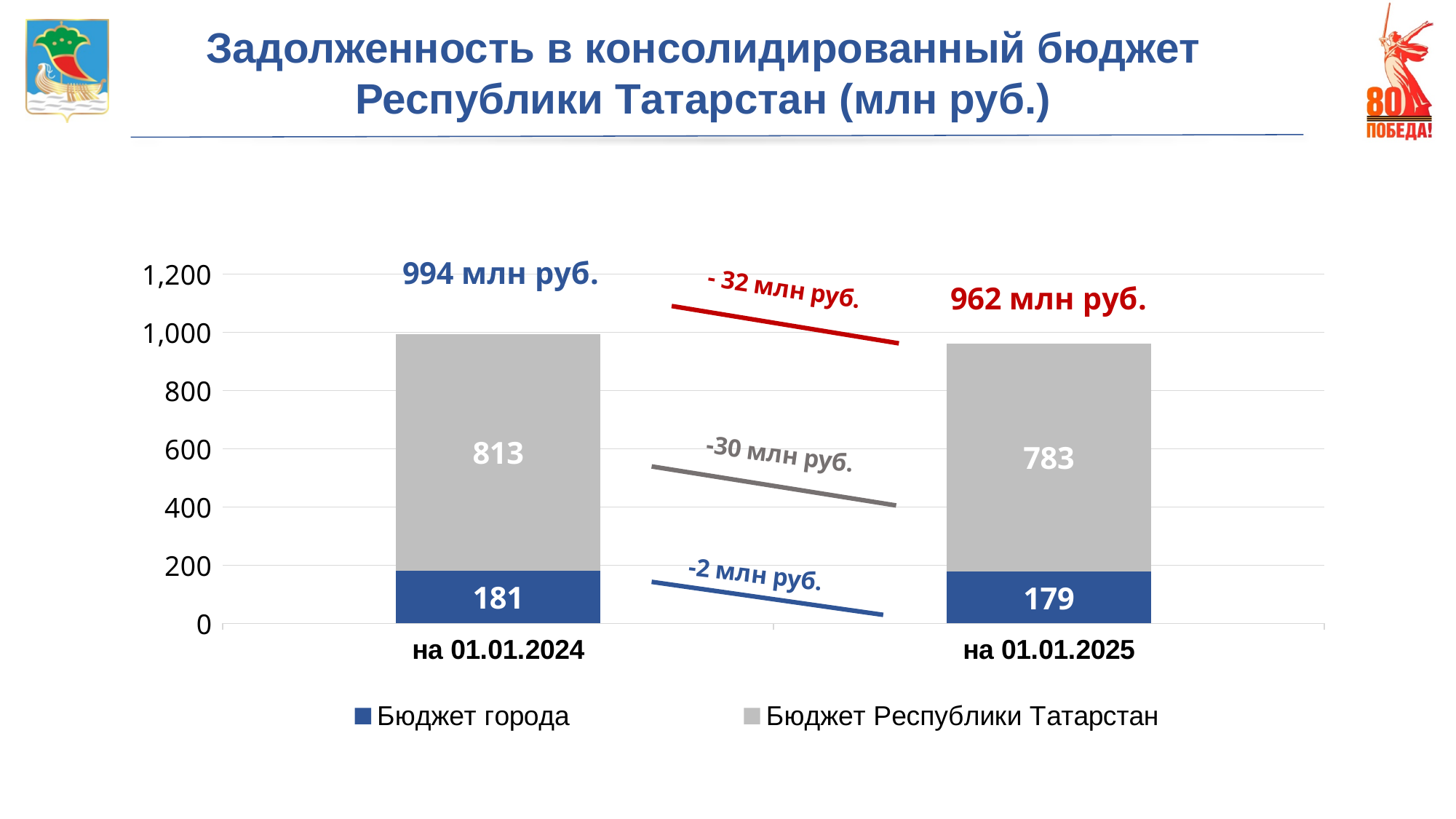
What kind of chart is shown on the slide? Stacked bar chart Which is larger: Бюджет города on 01.01.2024 or Бюджет города on 01.01.2025? 01.01.2024 What is the total of the stacked bar for 01.01.2025? 962 млн руб. What is the value for Бюджет города on 01.01.2024? 181 What is the difference between the Бюджет Республики Татарстан values on 01.01.2024 and 01.01.2025? 30 What is the value for Бюджет города on 01.01.2025? 179 How many categories are shown on the x axis? 2 How many series does the legend list? 2 What is the value for Бюджет Республики Татарстан on 01.01.2025? 783 What is the value for Бюджет Республики Татарстан on 01.01.2024? 813 What is the total of the stacked bar for 01.01.2024? 994 млн руб. Do the total values rise or fall from 01.01.2024 to 01.01.2025? Fall